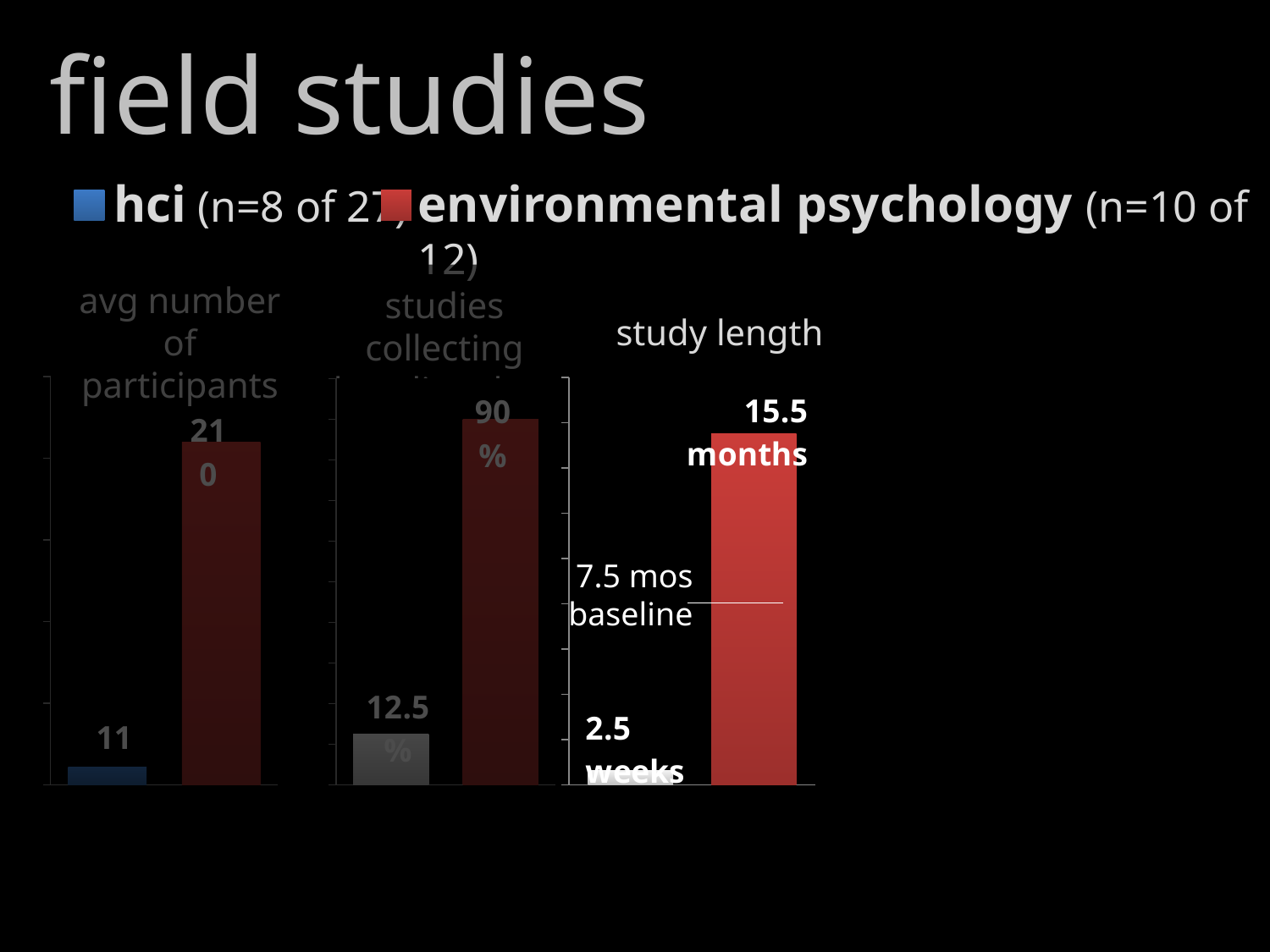
In the middle chart, what is the value for environmental psychology? 90% What are the two series named in the legend? hci and environmental psychology In the middle chart, what is the value for hci? 12.5% In the 'avg number of participants' chart, what is the value for environmental psychology? 210 How many series does the legend list? 2 What kind of chart is the 'study length' chart? bar chart In the 'avg number of participants' chart, what is the value for hci? 11 In the 'study length' chart, what is the value for hci? 2.5 weeks In the 'study length' chart, what is the value for environmental psychology? 15.5 months In the middle chart, which is larger, hci or environmental psychology? environmental psychology In the 'study length' chart, what baseline value is marked? 7.5 mos In the middle chart, what is the difference between the environmental psychology value and the hci value? 77.5%